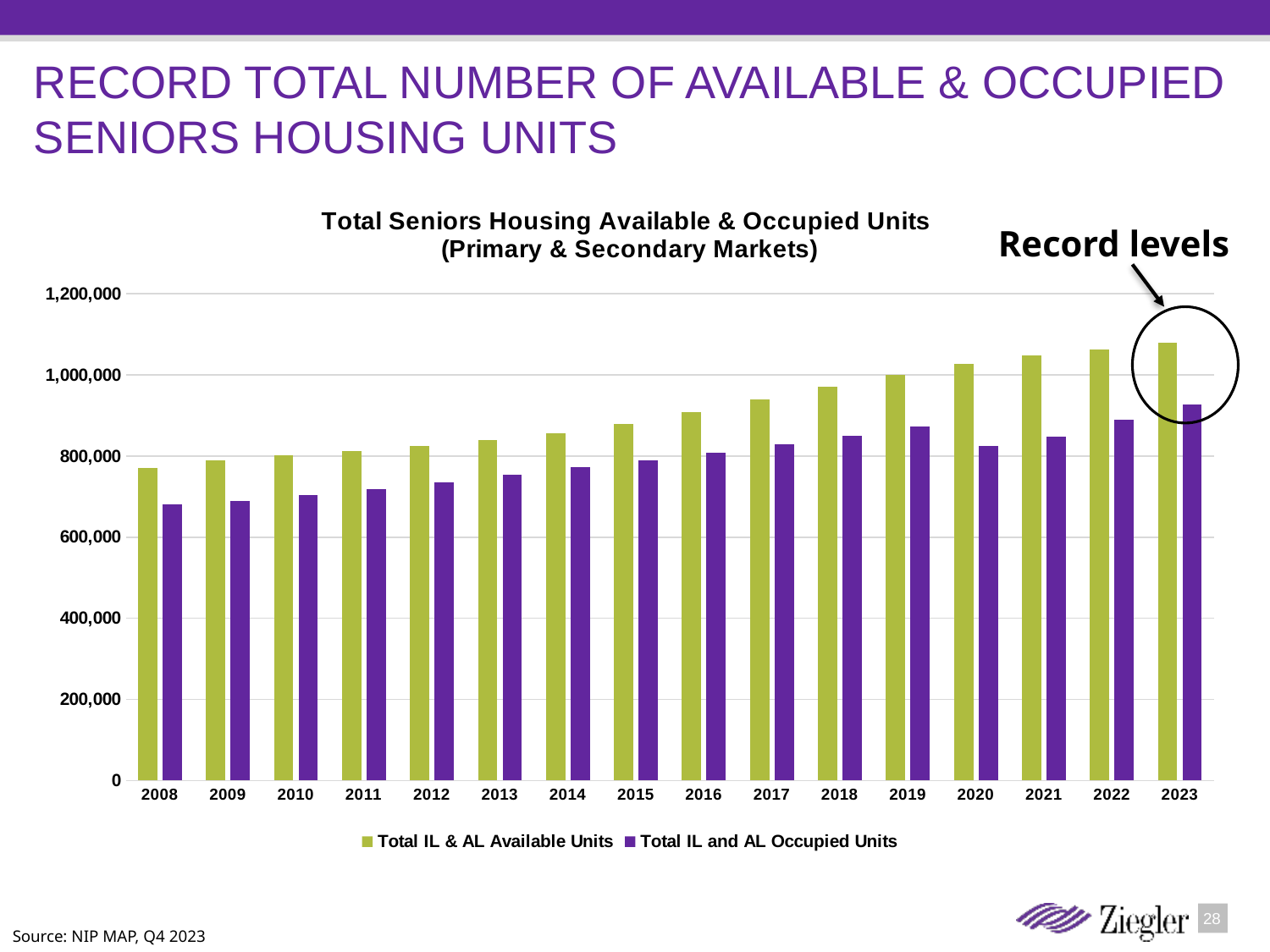
Is the value for Total IL & AL Available Units in 2021 greater or less than 1,000,000? greater Which year has the lowest value for Total IL and AL Occupied Units? 2008 Do the Total IL & AL Available Units values rise or fall from 2008 to 2023? rise How many years are shown on the x axis? 16 Is the value for Total IL & AL Available Units in 2023 greater or less than 1,000,000? greater In 2023, which is larger: Total IL & AL Available Units or Total IL and AL Occupied Units? Total IL & AL Available Units Which year has the highest value for Total IL & AL Available Units? 2023 Is the value for Total IL and AL Occupied Units in 2023 greater or less than 1,000,000? less How many series does the legend list? 2 What kind of chart is shown on the slide? bar chart What is the title of the chart? Total Seniors Housing Available & Occupied Units (Primary & Secondary Markets)